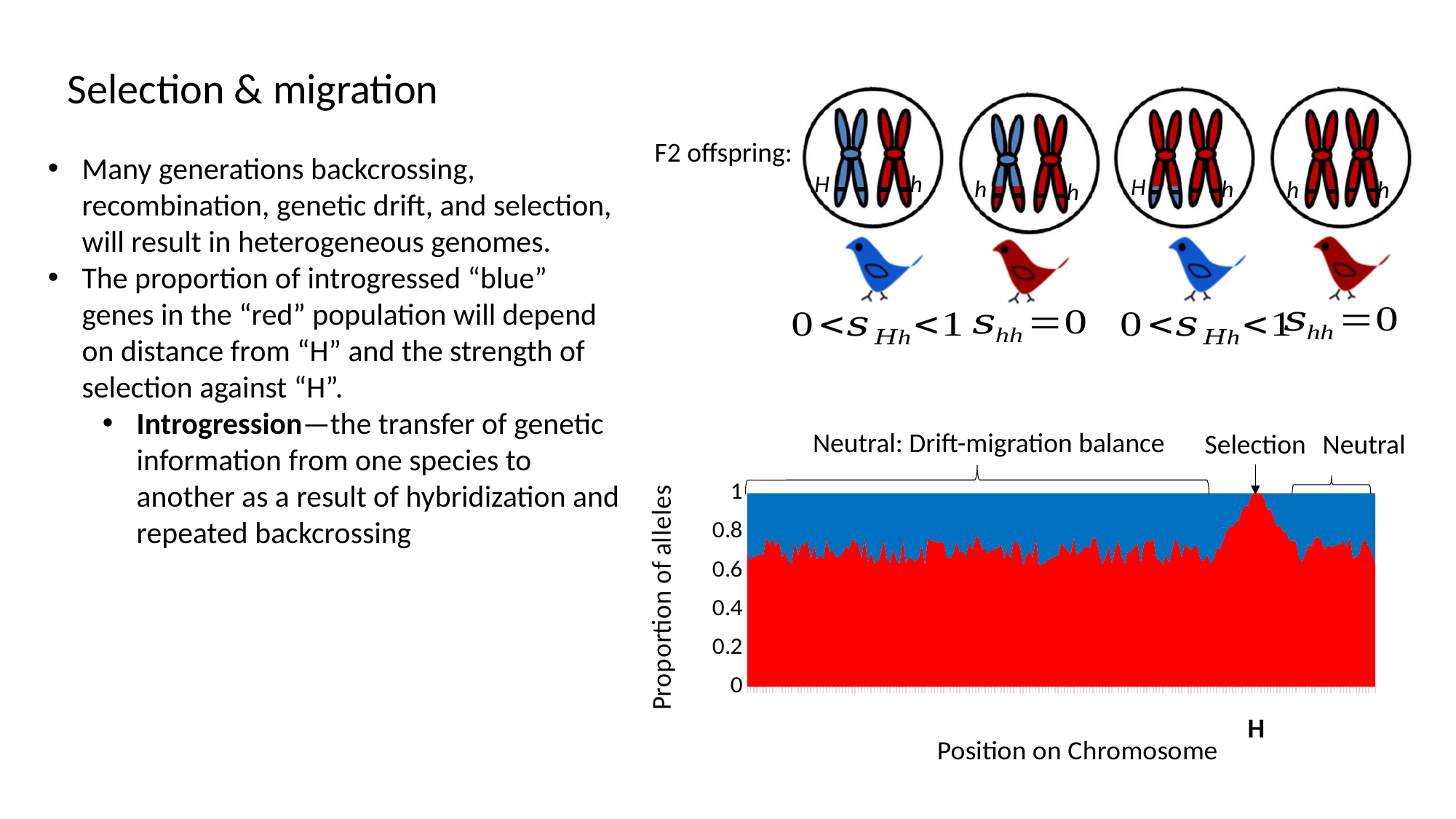
What is the highest value shown on the y axis of the chart? 1 What kind of chart is shown at the bottom right of the slide? area chart Which region of the chart is labelled 'Selection'? the peak at position H At the position marked H, is the proportion of red alleles greater or less than 0.8? greater Is the proportion of red alleles larger at the position marked H or in the region labelled 'Neutral: Drift-migration balance'? at H At which labelled position on the chromosome does the proportion of red alleles reach its highest value? H Is the proportion of blue alleles at the position marked H greater or less than 0.2? less What is the label of the x axis of the chart? Position on Chromosome In the region labelled 'Neutral: Drift-migration balance', is the proportion of red alleles greater or less than 0.4? greater What is the label of the y axis of the chart? Proportion of alleles What is the lowest value shown on the y axis of the chart? 0